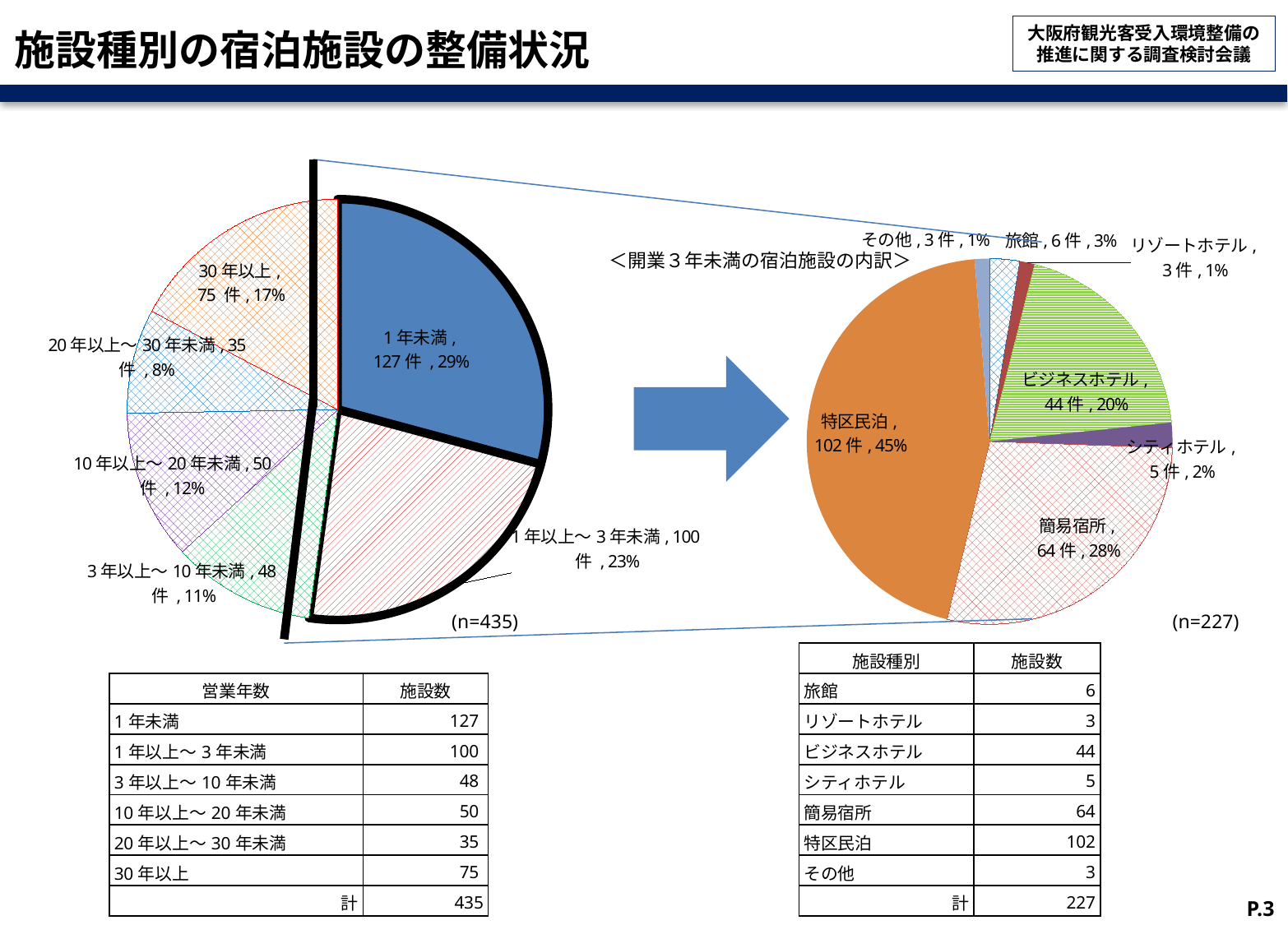
In the right pie chart (開業3年未満の宿泊施設の内訳), which category has the largest share? 特区民泊 In the right pie chart (開業3年未満の宿泊施設の内訳), which is larger, 簡易宿所 or ビジネスホテル? 簡易宿所 In the right pie chart (開業3年未満の宿泊施設の内訳), what percentage share does ビジネスホテル have? 20% In the left pie chart (n=435), how many facilities are in the 1年未満 category? 127件 What type of chart is used on the left side of the slide? Pie chart In the left pie chart (n=435), which category has the largest number of facilities? 1年未満 In the right pie chart (開業3年未満の宿泊施設の内訳), how many facilities are 特区民泊? 102件 In the right pie chart (開業3年未満の宿泊施設の内訳), what is the difference in facility count between 特区民泊 and 簡易宿所? 38件 In the left pie chart (n=435), how many categories are shown? 6 In the left pie chart (n=435), which category has the smallest number of facilities? 20年以上～30年未満 In the left pie chart (n=435), what is the difference in facility count between 1年未満 and 1年以上～3年未満? 27件 In the left pie chart (n=435), what percentage share does 30年以上 have? 17%